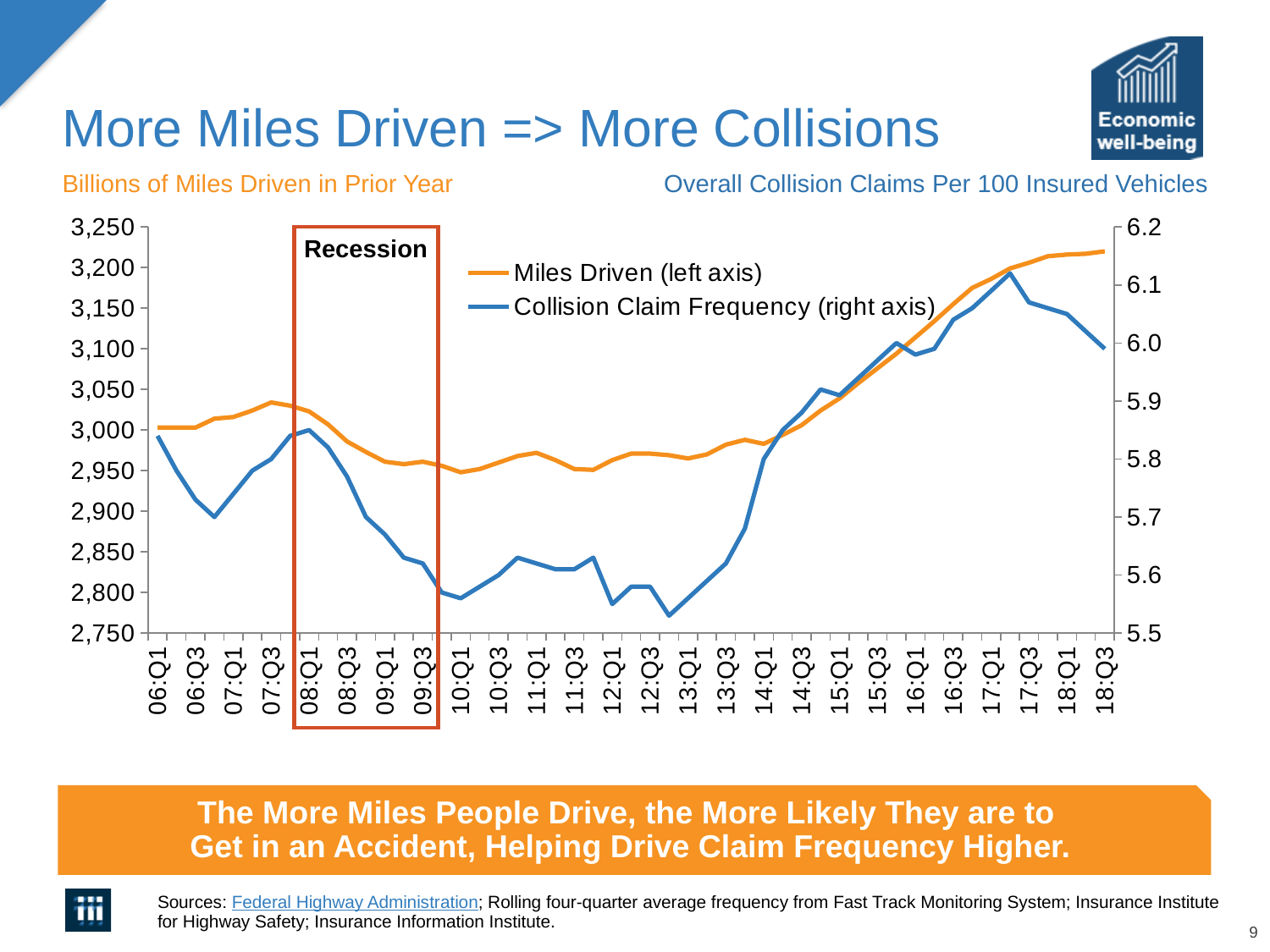
Is the Miles Driven value at 18:Q3 greater or less than 3,200? greater Which series is plotted against the right axis? Collision Claim Frequency Is the Collision Claim Frequency value at 17:Q1 greater or less than 6.0? greater Is the Collision Claim Frequency value at 06:Q3 greater or less than 5.8? less How many series does the chart's legend list? 2 At which quarter does the Miles Driven series reach its highest value? 18:Q3 Does the Miles Driven series rise or fall between 14:Q1 and 18:Q3? rise What label is shown inside the red box on the chart? Recession What kind of chart is shown on the slide? Line chart At which quarter does the Collision Claim Frequency series reach its highest value? 17:Q2